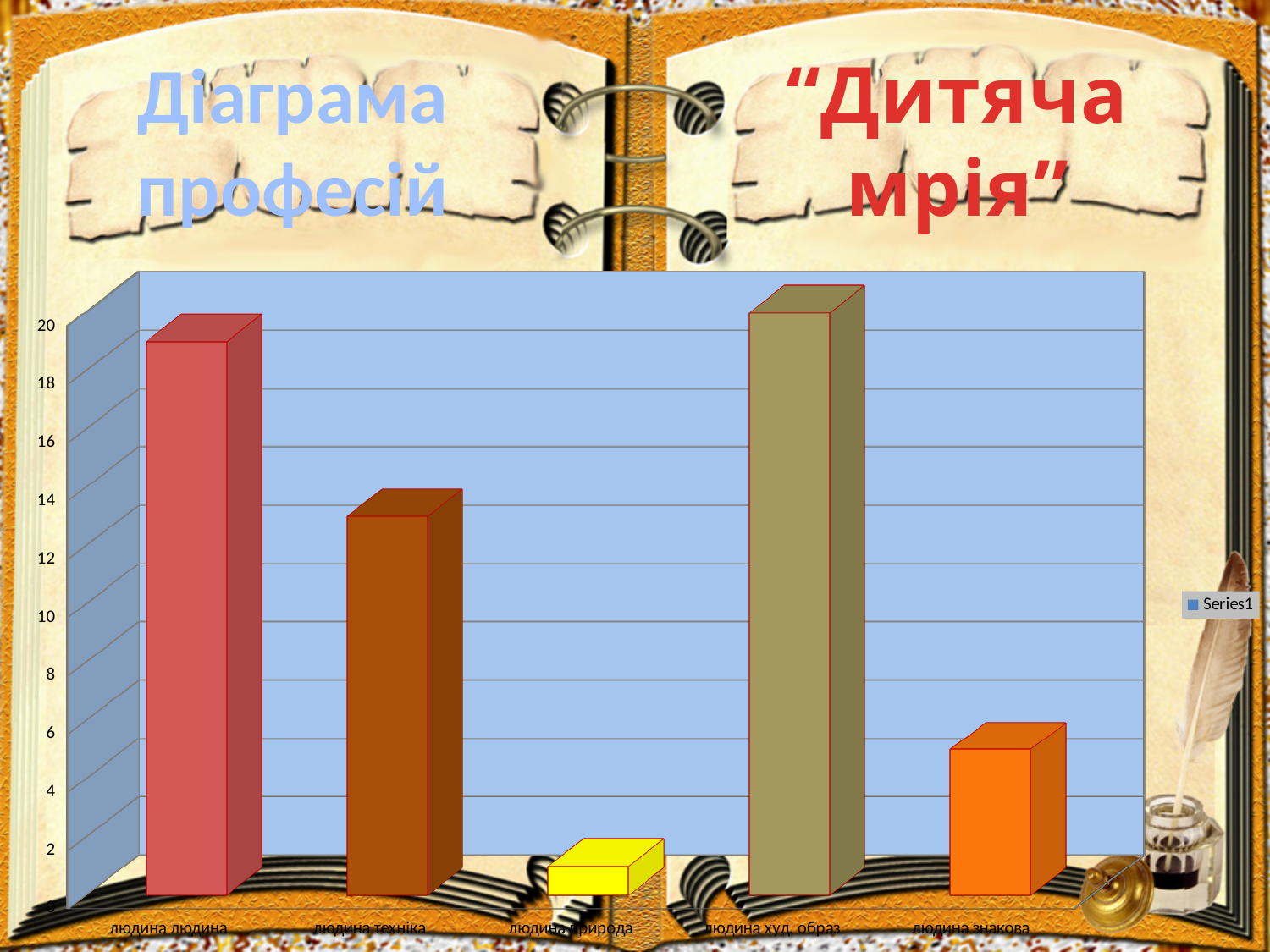
What is the name of the series shown in the chart legend? Series1 Which category has the lowest bar in the chart? людина природа How many series does the chart legend list? 1 Is the value for людина знакова greater or less than 10? less Is the value for людина природа greater or less than 4? less What kind of chart is shown on the slide? bar chart How many categories are shown on the x axis of the chart? 5 Which is larger, the value for людина людина or the value for людина природа? людина людина Is the value for людина техніка greater or less than 10? greater Which is larger, the value for людина техніка or the value for людина знакова? людина техніка